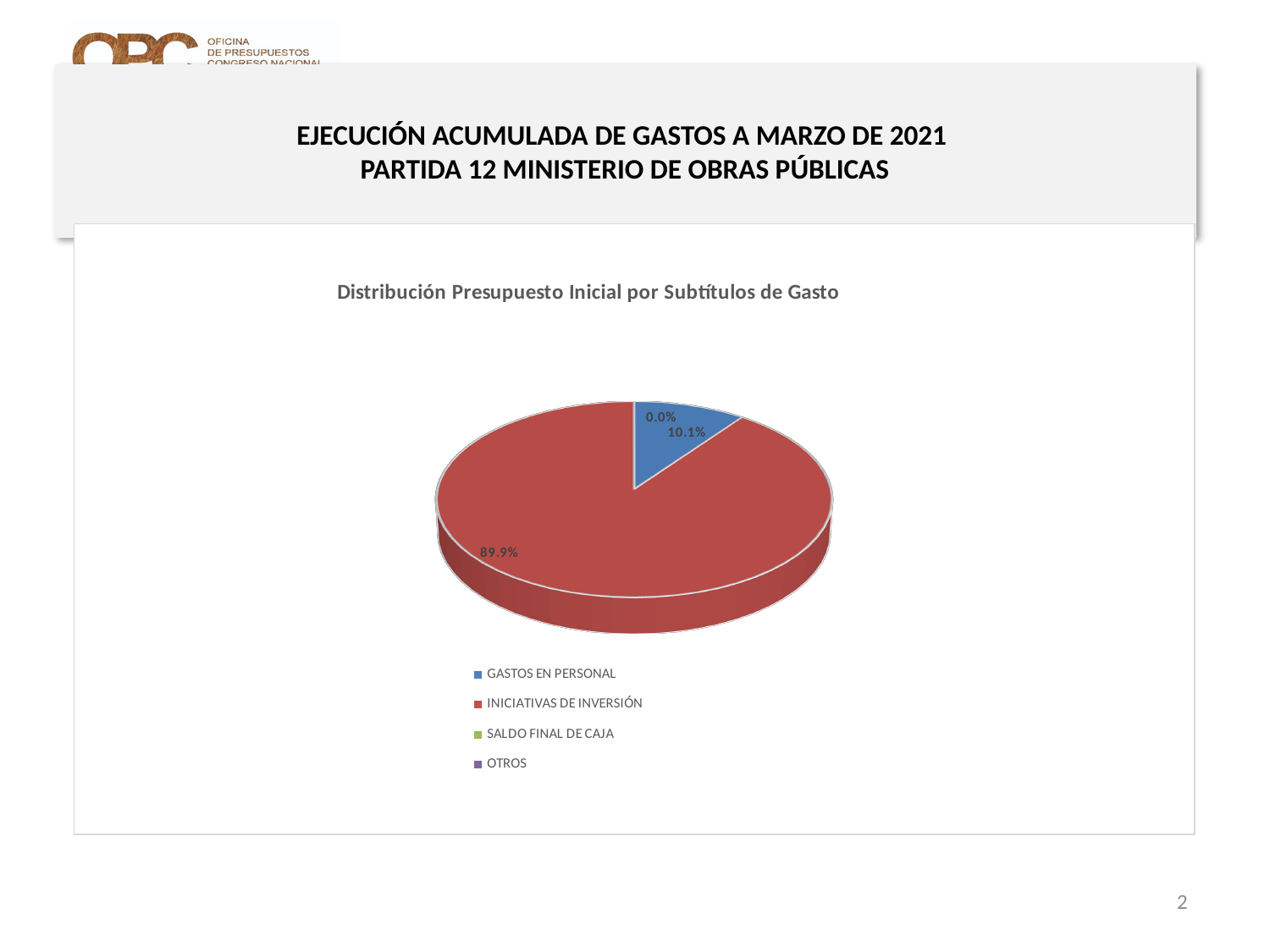
What kind of chart is shown on the slide? pie chart Which category has the largest slice of the pie? INICIATIVAS DE INVERSIÓN What colour is the slice for INICIATIVAS DE INVERSIÓN? red What is the title of the chart? Distribución Presupuesto Inicial por Subtítulos de Gasto How many categories are listed in the chart's legend? 4 What is the difference in percentage points between the INICIATIVAS DE INVERSIÓN slice and the GASTOS EN PERSONAL slice? 79.8 percentage points Which is larger, the slice for GASTOS EN PERSONAL or the slice for INICIATIVAS DE INVERSIÓN? INICIATIVAS DE INVERSIÓN What share of the pie does GASTOS EN PERSONAL represent? 10.1% What is the combined share of GASTOS EN PERSONAL and INICIATIVAS DE INVERSIÓN? 100.0% What is the smallest percentage value labelled on the pie? 0.0% What share of the pie does INICIATIVAS DE INVERSIÓN represent? 89.9%